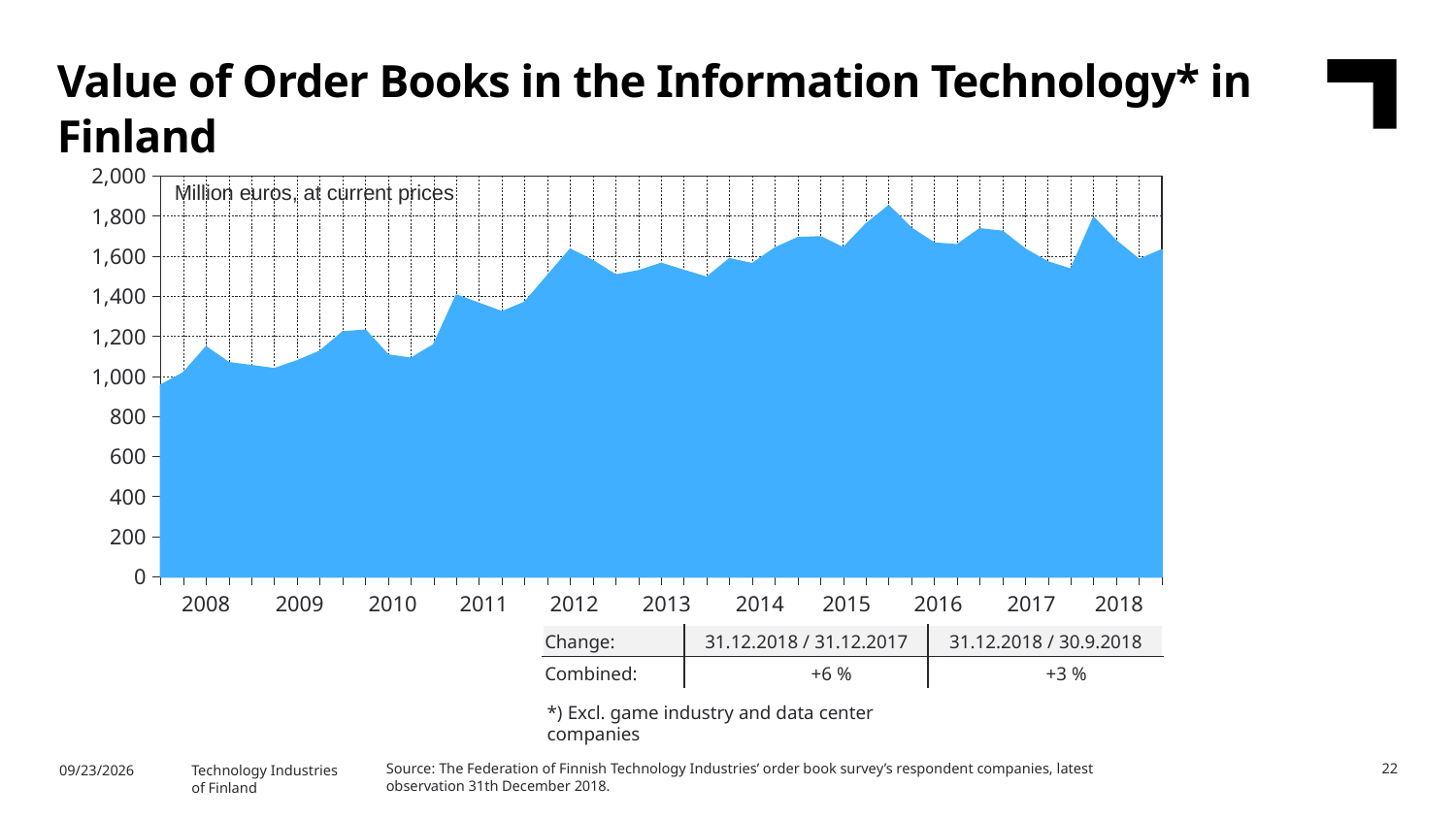
In which year does the chart show its lowest value? 2008 What kind of chart is shown on the slide? area chart In which year does the chart reach its highest value? 2015 Overall, do the values rise or fall from 2008 to 2018? rise Is the value at the end of 2018 greater or less than 1,400? greater According to the table below the chart, what is the combined change from 31.12.2017 to 31.12.2018? +6 % What is the title of the chart? Value of Order Books in the Information Technology* in Finland In what unit are the values on the chart expressed, according to the label inside the plot area? Million euros, at current prices Is the peak value in 2015 greater or less than 1,800? greater Which is larger, the value at the start of 2008 or the value at the end of 2018? end of 2018 How many years are labelled on the x axis? 11